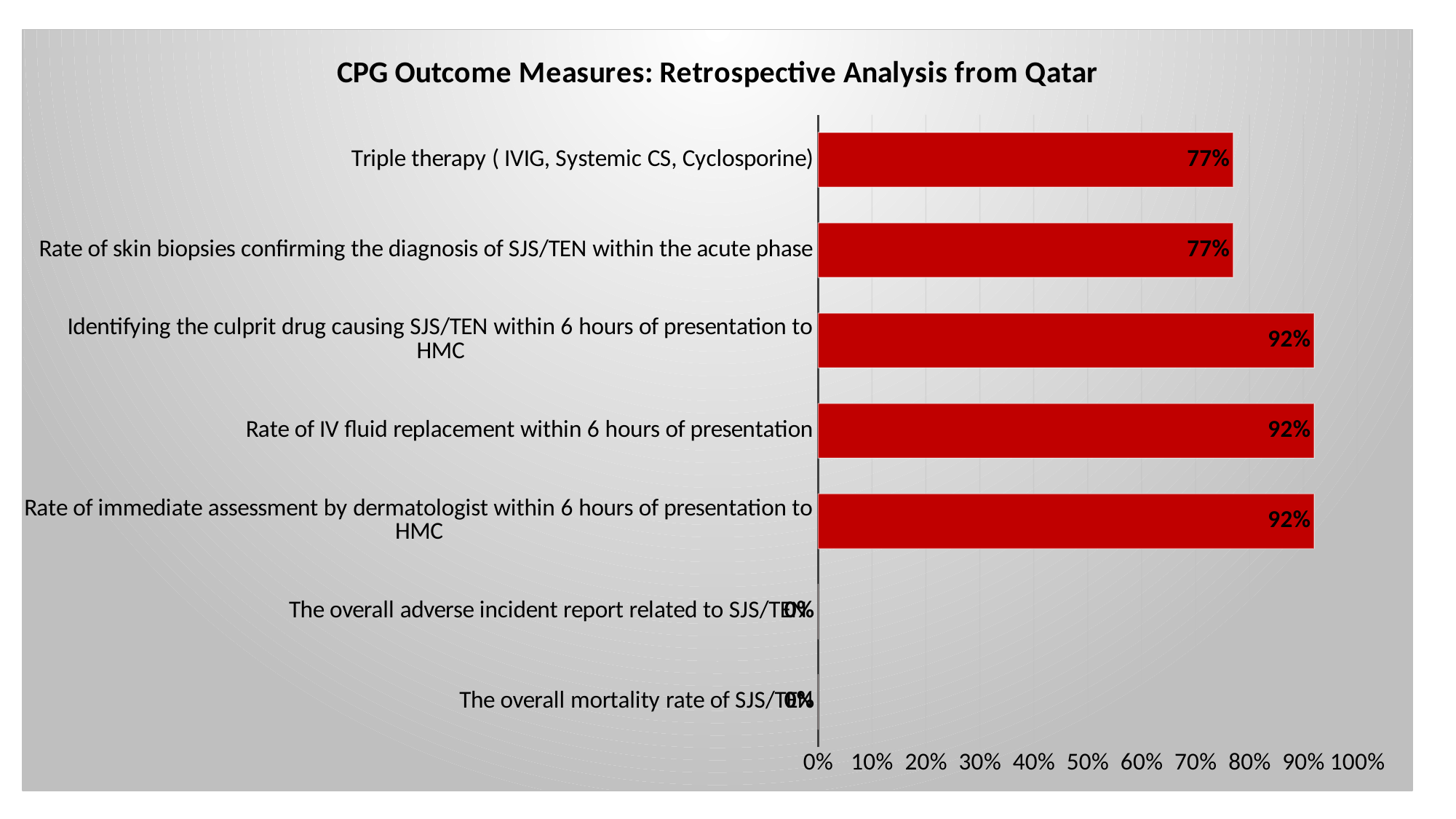
What is the value for The overall mortality rate of SJS/TEN? 0% What is the value for Triple therapy ( IVIG, Systemic CS, Cyclosporine)? 77% What is the difference between the value for Identifying the culprit drug causing SJS/TEN within 6 hours of presentation to HMC and the value for Triple therapy ( IVIG, Systemic CS, Cyclosporine)? 15% How many categories are shown in the chart? 7 Is the value for Rate of IV fluid replacement within 6 hours of presentation greater or less than 90%? greater What kind of chart is shown on the slide? Bar chart What is the value for Rate of IV fluid replacement within 6 hours of presentation? 92% What colour are the bars in the chart? Red What is the title of the chart? CPG Outcome Measures: Retrospective Analysis from Qatar Is the value for Triple therapy ( IVIG, Systemic CS, Cyclosporine) greater or less than 80%? less What is the value for Rate of skin biopsies confirming the diagnosis of SJS/TEN within the acute phase? 77% Which is larger: the value for Rate of immediate assessment by dermatologist within 6 hours of presentation to HMC or the value for Rate of skin biopsies confirming the diagnosis of SJS/TEN within the acute phase? Rate of immediate assessment by dermatologist within 6 hours of presentation to HMC